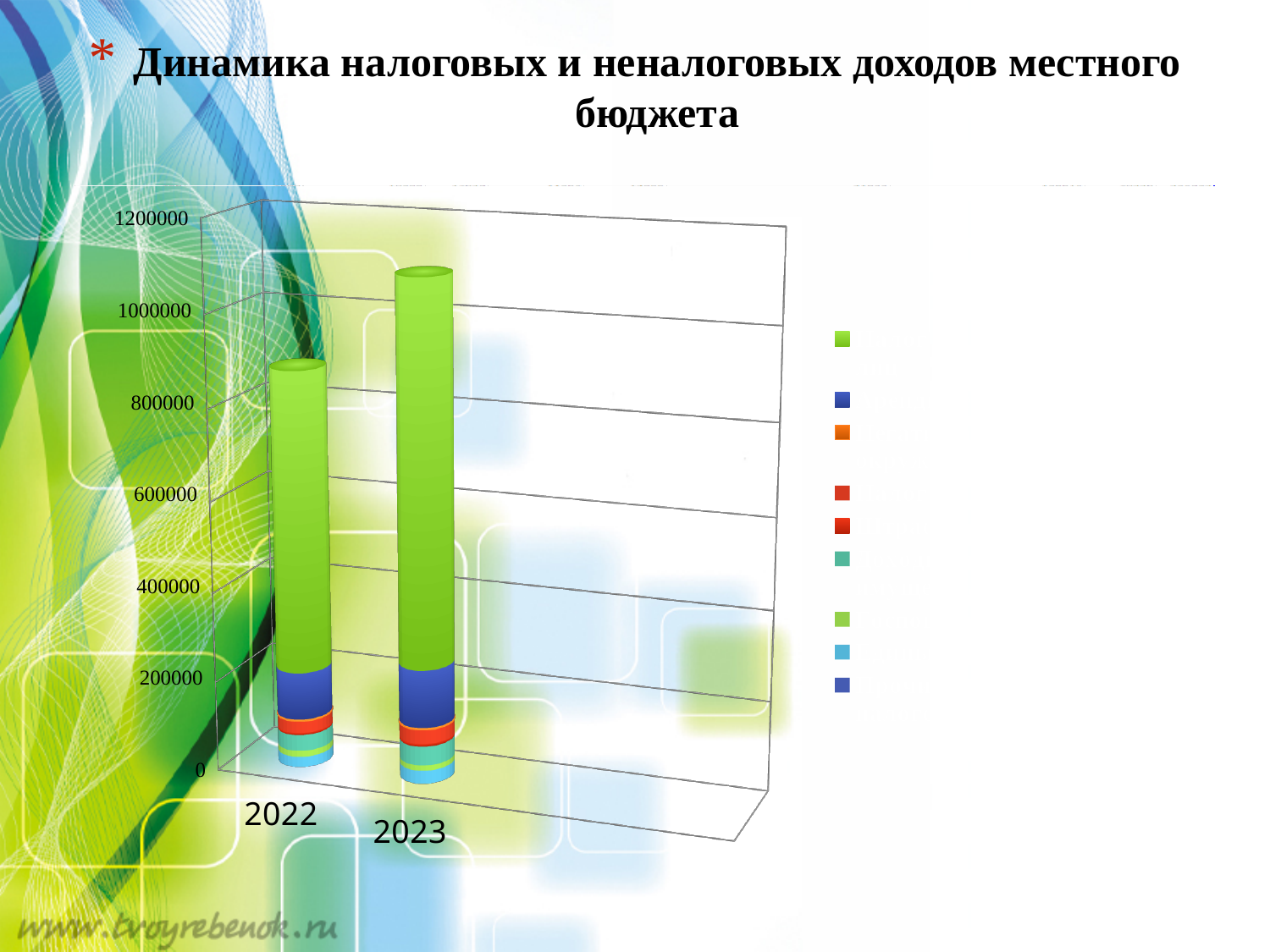
Which year has the taller stacked bar, 2022 or 2023? 2023 Is the total value of the 2023 bar greater or less than 800000? greater What is the highest value shown on the chart's vertical axis? 1200000 Do the total values rise or fall from 2022 to 2023? rise What is the title of the slide containing the chart? Динамика налоговых и неналоговых доходов местного бюджета What kind of chart is shown on the slide? bar chart Is the total value of the 2023 bar greater or less than 1200000? less How many series does the chart's legend list? 9 How many categories (years) are shown on the x axis of the chart? 2 Is the total value of the 2022 bar greater or less than 1000000? less